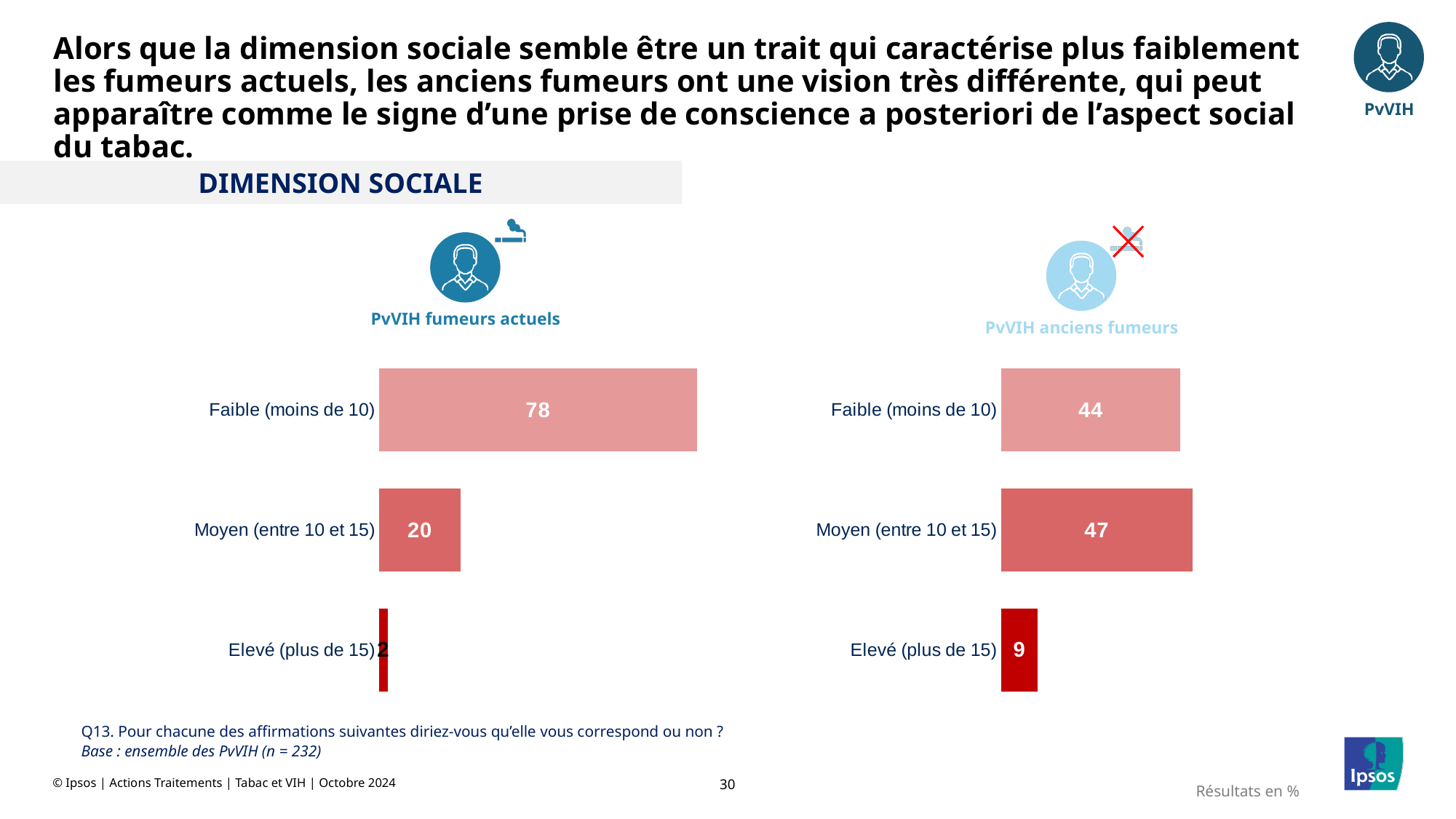
Which is larger: 'Elevé (plus de 15)' in the 'PvVIH fumeurs actuels' chart or 'Elevé (plus de 15)' in the 'PvVIH anciens fumeurs' chart? PvVIH anciens fumeurs In the 'PvVIH fumeurs actuels' chart, what is the difference between 'Faible (moins de 10)' and 'Moyen (entre 10 et 15)'? 58 What is the section heading shown above the two charts? DIMENSION SOCIALE In the 'PvVIH fumeurs actuels' chart, what is the value for 'Faible (moins de 10)'? 78 How many categories are shown in the 'PvVIH fumeurs actuels' chart? 3 In the 'PvVIH anciens fumeurs' chart, what is the value for 'Elevé (plus de 15)'? 9 What is the difference between the 'Faible (moins de 10)' value in the 'PvVIH fumeurs actuels' chart and the 'Faible (moins de 10)' value in the 'PvVIH anciens fumeurs' chart? 34 What kind of chart is the 'PvVIH anciens fumeurs' chart? Bar chart In the 'PvVIH anciens fumeurs' chart, which category has the highest value? Moyen (entre 10 et 15) In the 'PvVIH fumeurs actuels' chart, which category has the highest value? Faible (moins de 10) In the 'PvVIH anciens fumeurs' chart, what is the value for 'Moyen (entre 10 et 15)'? 47 In the 'PvVIH anciens fumeurs' chart, which category has the lowest value? Elevé (plus de 15)